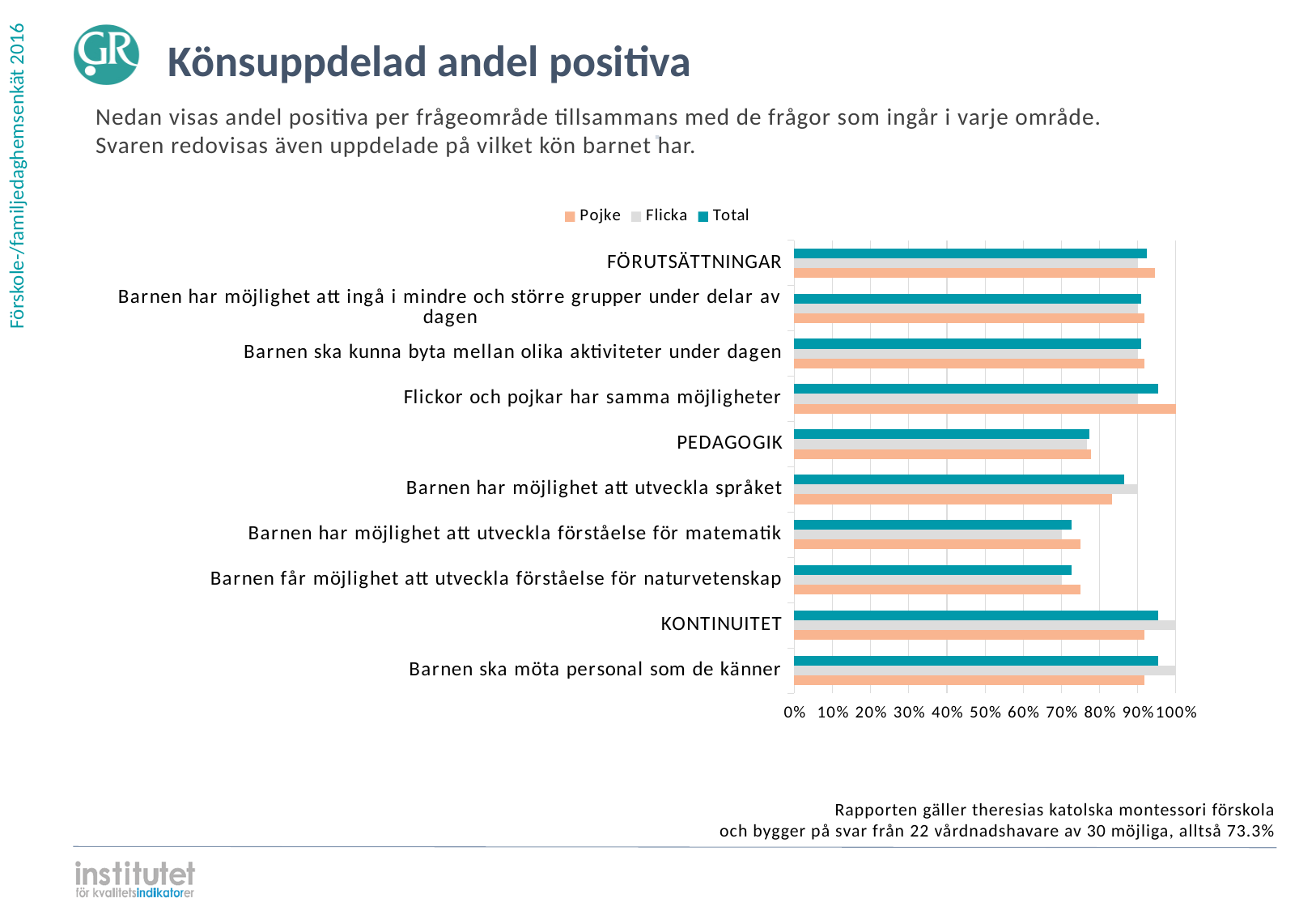
What is the title of the slide containing the chart? Könsuppdelad andel positiva What is the Pojke value for 'Flickor och pojkar har samma möjligheter'? 100% Is the Total value for 'Barnen har möjlighet att utveckla förståelse för matematik' greater or less than 80%? less Is the Total value for 'Barnen har möjlighet att utveckla språket' greater or less than 80%? greater How many categories are plotted on the y axis of the chart? 10 For 'Barnen har möjlighet att utveckla språket', which is larger, the Pojke value or the Flicka value? Flicka Which category has the highest Pojke value? Flickor och pojkar har samma möjligheter Which series is shown in orange in the legend? Pojke For FÖRUTSÄTTNINGAR, which is larger, the Pojke value or the Flicka value? Pojke What kind of chart is shown on the slide? bar chart Is the Flicka value for KONTINUITET greater or less than 90%? greater How many series does the legend list? 3